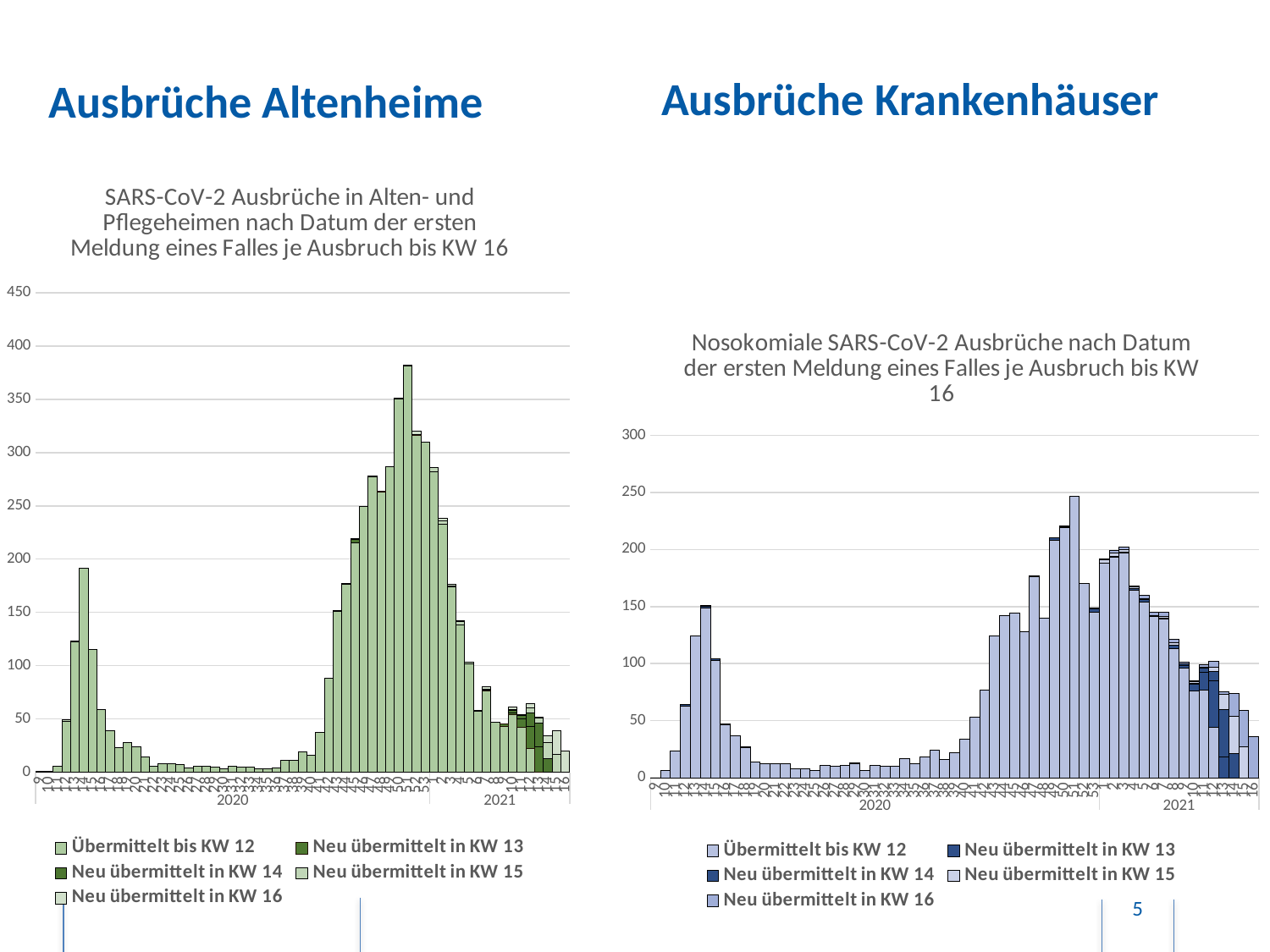
In the left chart (Alten- und Pflegeheime), is the first peak in early 2020 greater or less than 150? greater In the left chart (Alten- und Pflegeheime), is the tallest bar greater or less than 350? greater In the right chart (Nosokomiale Ausbrüche), do the bars generally rise or fall across the 2021 weeks? Fall What is the highest value shown on the vertical axis of the left chart (Alten- und Pflegeheime)? 450 What kind of chart is the left chart, 'SARS-CoV-2 Ausbrüche in Alten- und Pflegeheimen'? Bar chart In the left chart (Alten- und Pflegeheime), in which year does the tallest bar occur? 2020 Which chart has the higher peak bar, the left chart (Alten- und Pflegeheime) or the right chart (Nosokomiale Ausbrüche)? The left chart (Alten- und Pflegeheime) In the right chart (Nosokomiale Ausbrüche), is the first peak in early 2020 greater or less than 100? greater What kind of chart is the right chart, 'Nosokomiale SARS-CoV-2 Ausbrüche'? Bar chart How many series does the legend of the left chart (Alten- und Pflegeheime) list? 5 How many series does the legend of the right chart (Nosokomiale Ausbrüche) list? 5